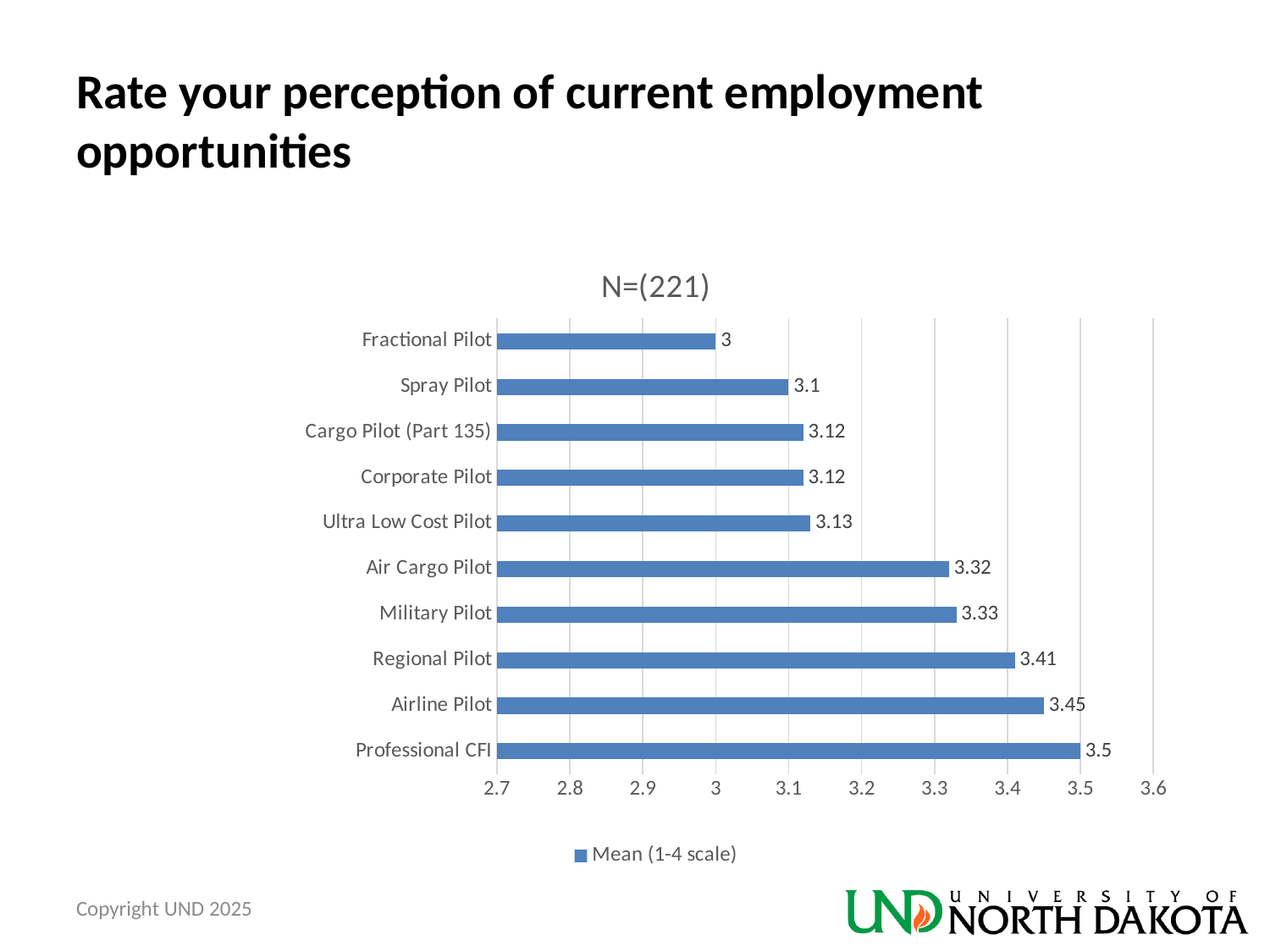
Which has a larger mean value, Ultra Low Cost Pilot or Air Cargo Pilot? Air Cargo Pilot What is the difference between the mean values for Regional Pilot and Air Cargo Pilot? 0.09 What is the legend entry for the series in the chart? Mean (1-4 scale) What is the mean value for Airline Pilot? 3.45 What is the mean value for Spray Pilot? 3.1 How many categories are shown in the chart? 10 Which category has the lowest mean value? Fractional Pilot What is the mean value for Military Pilot? 3.33 What kind of chart is shown on the slide? Bar chart Which category has the highest mean value? Professional CFI Which has a larger mean value, Airline Pilot or Regional Pilot? Airline Pilot What is the difference between the mean values for Professional CFI and Fractional Pilot? 0.5